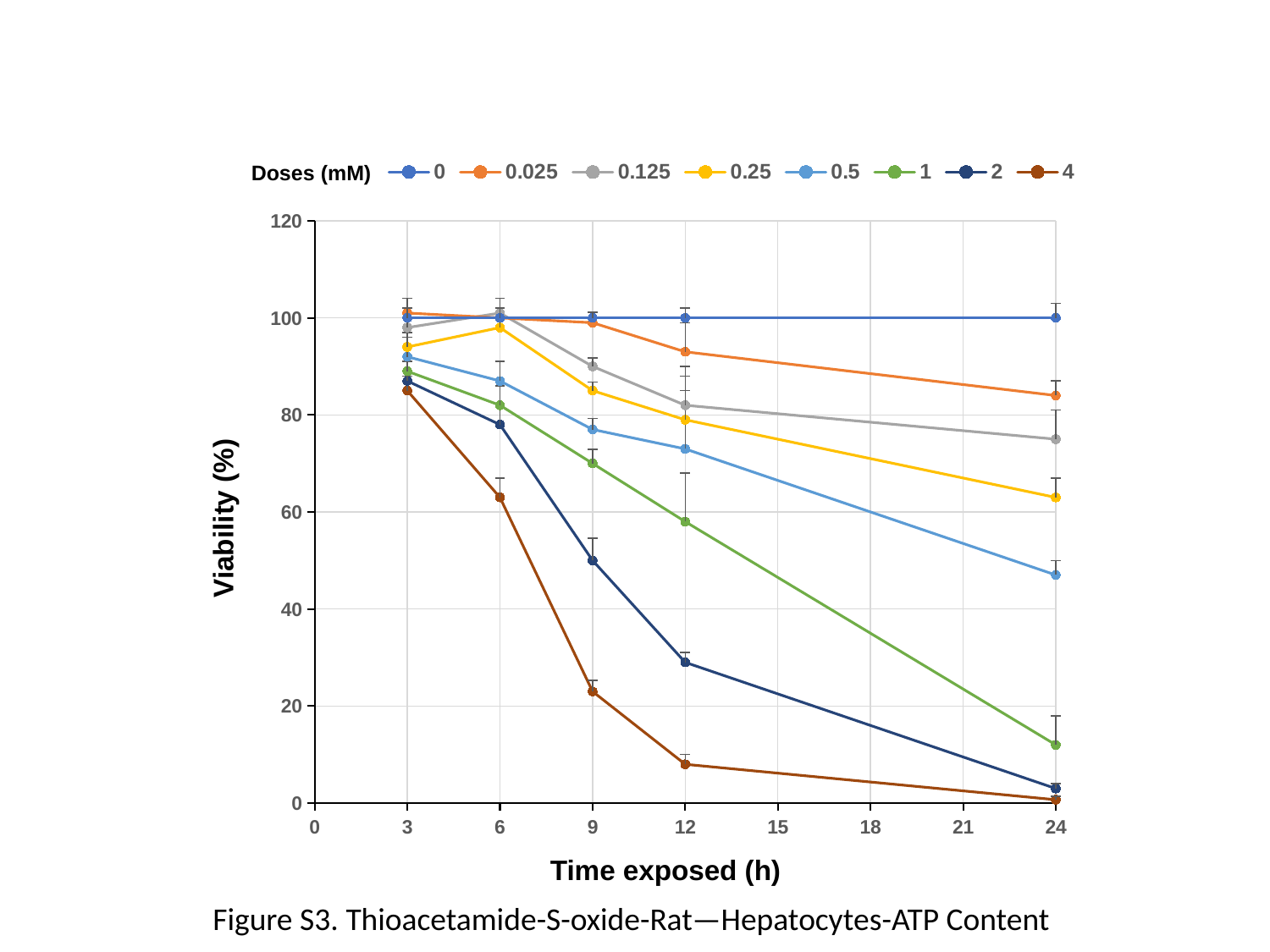
How many time points are plotted for each dose series? 5 What kind of chart is shown on the slide? line chart Which dose has the lowest viability at 12 h? 4 Is the viability for the 4 mM dose at 9 h greater or less than 20? greater Is the viability for the 1 mM dose at 24 h greater or less than 20? less Which dose has the highest viability at 24 h? 0 What is the label of the y axis? Viability (%) How many dose series does the legend list? 8 At 24 h, which dose has the higher viability, 0.25 mM or 0.5 mM? 0.25 Does the viability for the 4 mM dose rise or fall as time exposed increases? fall At 9 h, which dose has the higher viability, 0.5 mM or 1 mM? 0.5 What is the viability (%) for the 0 mM dose at 12 h? 100